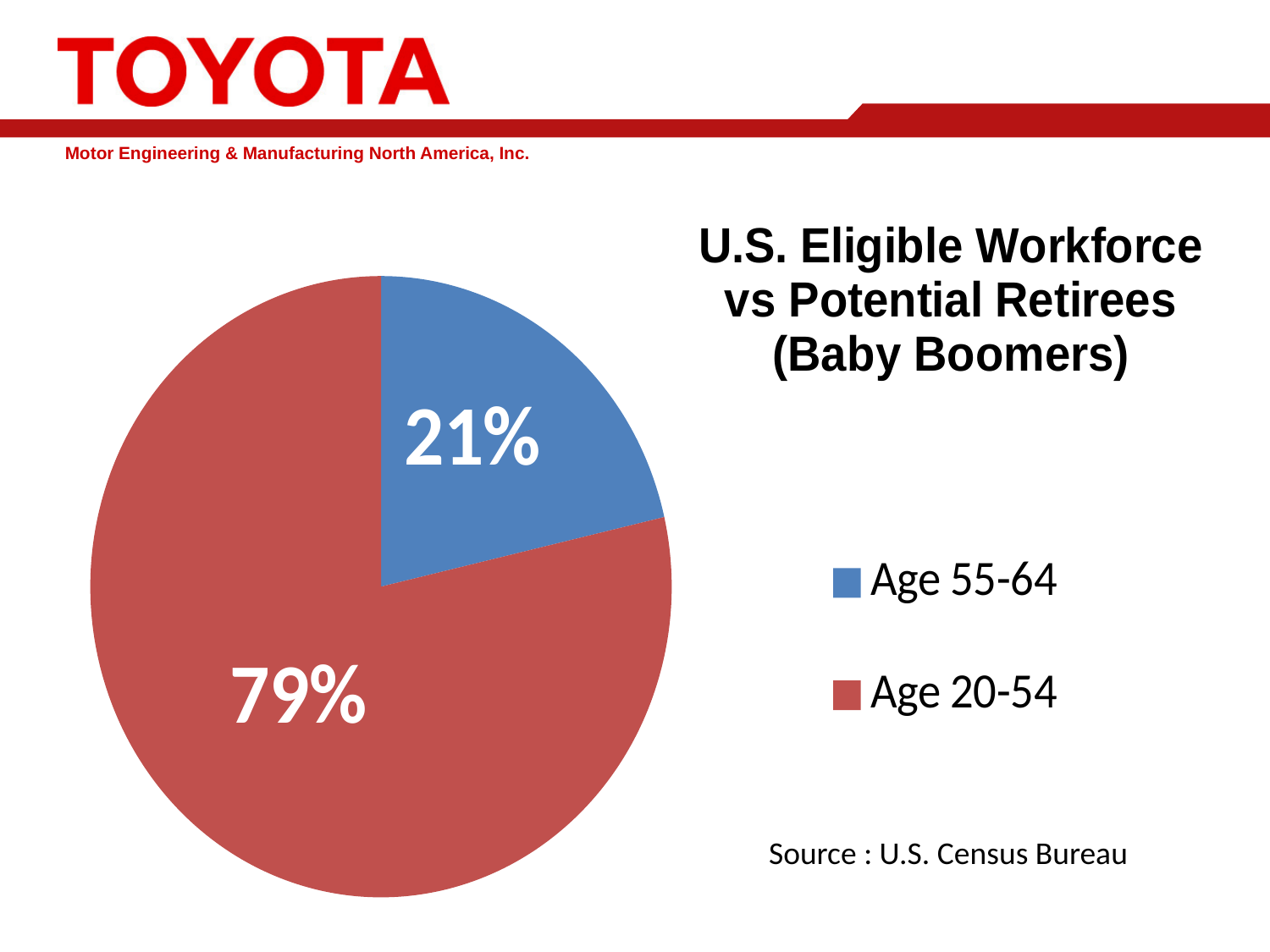
What share of the pie does the Age 55-64 slice represent? 21% What is the difference in percentage points between the Age 20-54 slice and the Age 55-64 slice? 58 What kind of chart is shown on the slide? pie chart How many slices does the pie chart have? 2 What share of the pie does the Age 20-54 slice represent? 79% Which age group has the largest slice of the pie? Age 20-54 What is the total of the two slice percentages shown? 100% Which slice is larger, Age 55-64 or Age 20-54? Age 20-54 What is the title of the chart? U.S. Eligible Workforce vs Potential Retirees (Baby Boomers) Which age group has the smallest slice of the pie? Age 55-64 How many entries does the legend list? 2 What colour is the Age 55-64 slice? blue